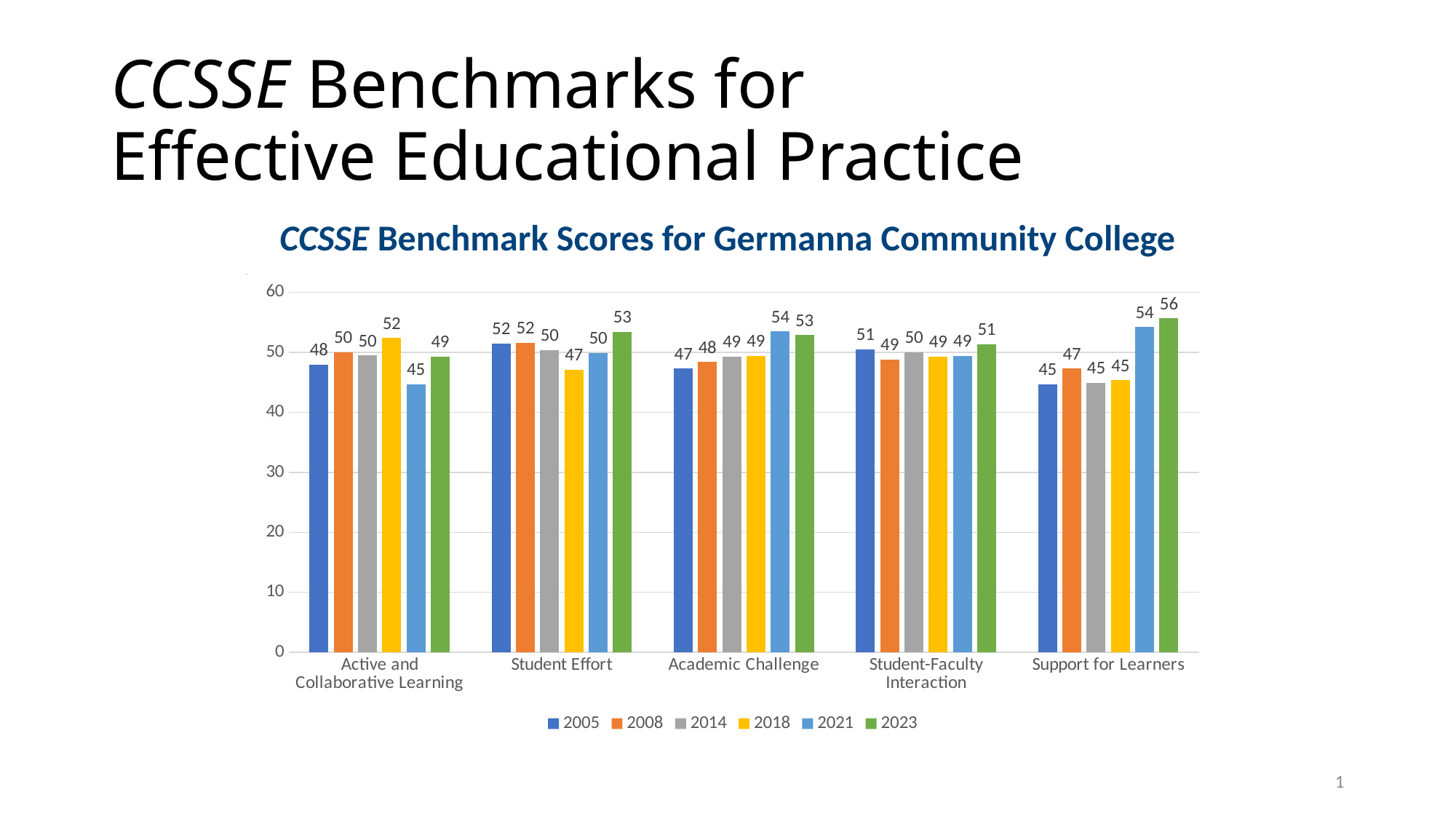
Which category has the lowest 2021 value? Active and Collaborative Learning What is the 2021 value for Active and Collaborative Learning? 45 What is the title of the chart? CCSSE Benchmark Scores for Germanna Community College What kind of chart is this? Bar chart What is the 2018 value for Student Effort? 47 How many categories are shown on the x axis? 5 What is the difference between the 2023 and 2005 values for Support for Learners? 11 What is the 2005 value for Academic Challenge? 47 Which category has the highest 2023 value? Support for Learners Which is larger for Student Effort: the 2018 value or the 2023 value? 2023 What is the 2023 value for Support for Learners? 56 How many series does the legend list? 6